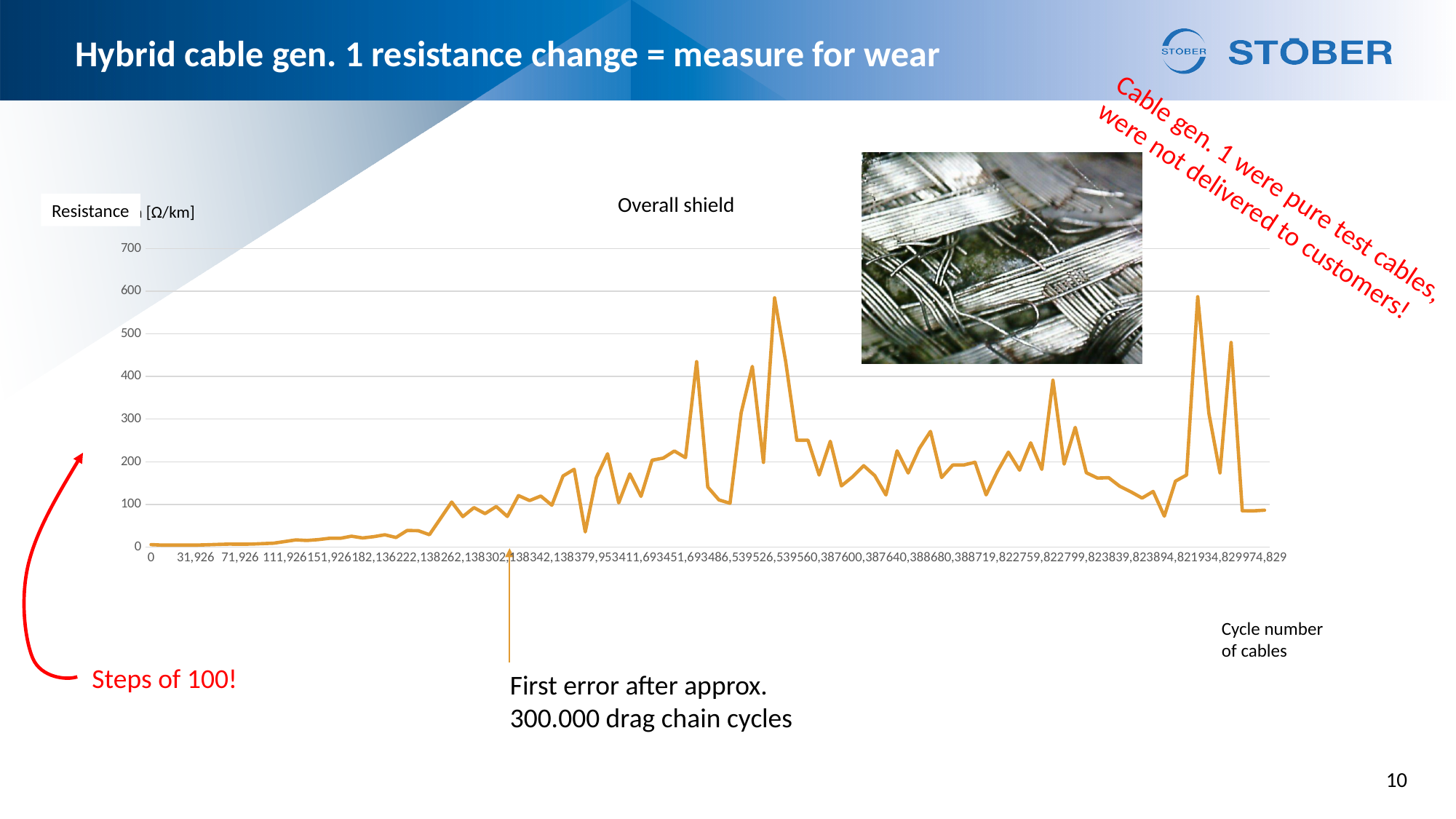
Is the peak resistance value near cycle number 560,387 greater or less than 500? greater Is the resistance value at cycle number 974,829 greater or less than 200? less What is the label of the vertical axis of the chart? Resistance [Ω/km] What kind of chart is shown on the slide? line chart Is the resistance value at cycle number 0 greater or less than 100? less Do the resistance values generally rise or fall along the x axis from 0 to 974,829 cycles? rise What is the highest value shown on the vertical axis of the chart? 700 Which has the larger resistance value: cycle number 0 or cycle number 560,387? 560,387 How many data series are plotted in the chart? 1 What is the title of the chart? Overall shield